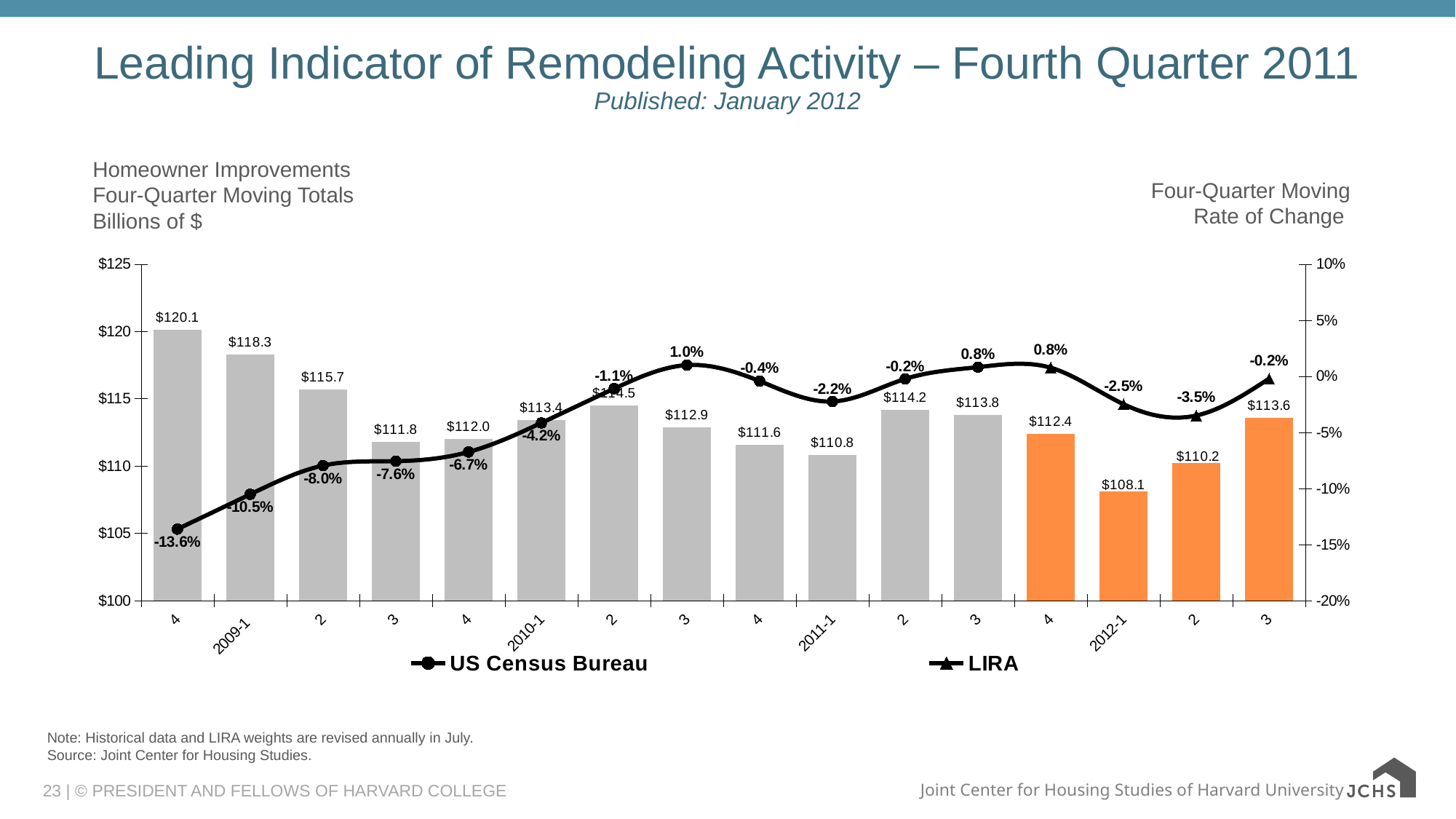
What is the four-quarter moving total for 2009-1? $118.3 Which quarter has the lowest four-quarter moving total bar? 2012-1 What is the four-quarter moving rate of change shown for 2010-3? 1.0% What is the difference between the four-quarter moving totals for 2010-1 and 2011-1? $2.6 What is the four-quarter moving rate of change shown for 2012-2? -3.5% How many bars are plotted in the chart? 16 What is the four-quarter moving total for 2011-1? $110.8 How many series does the legend list? 2 Does the rate of change line rise or fall from the first quarter shown to 2010-3? rise What is the lowest four-quarter moving rate of change shown on the line? -13.6% Which is larger, the four-quarter moving total for 2011-2 or for 2011-3? 2011-2 What is the highest four-quarter moving total value shown on the bars? $120.1